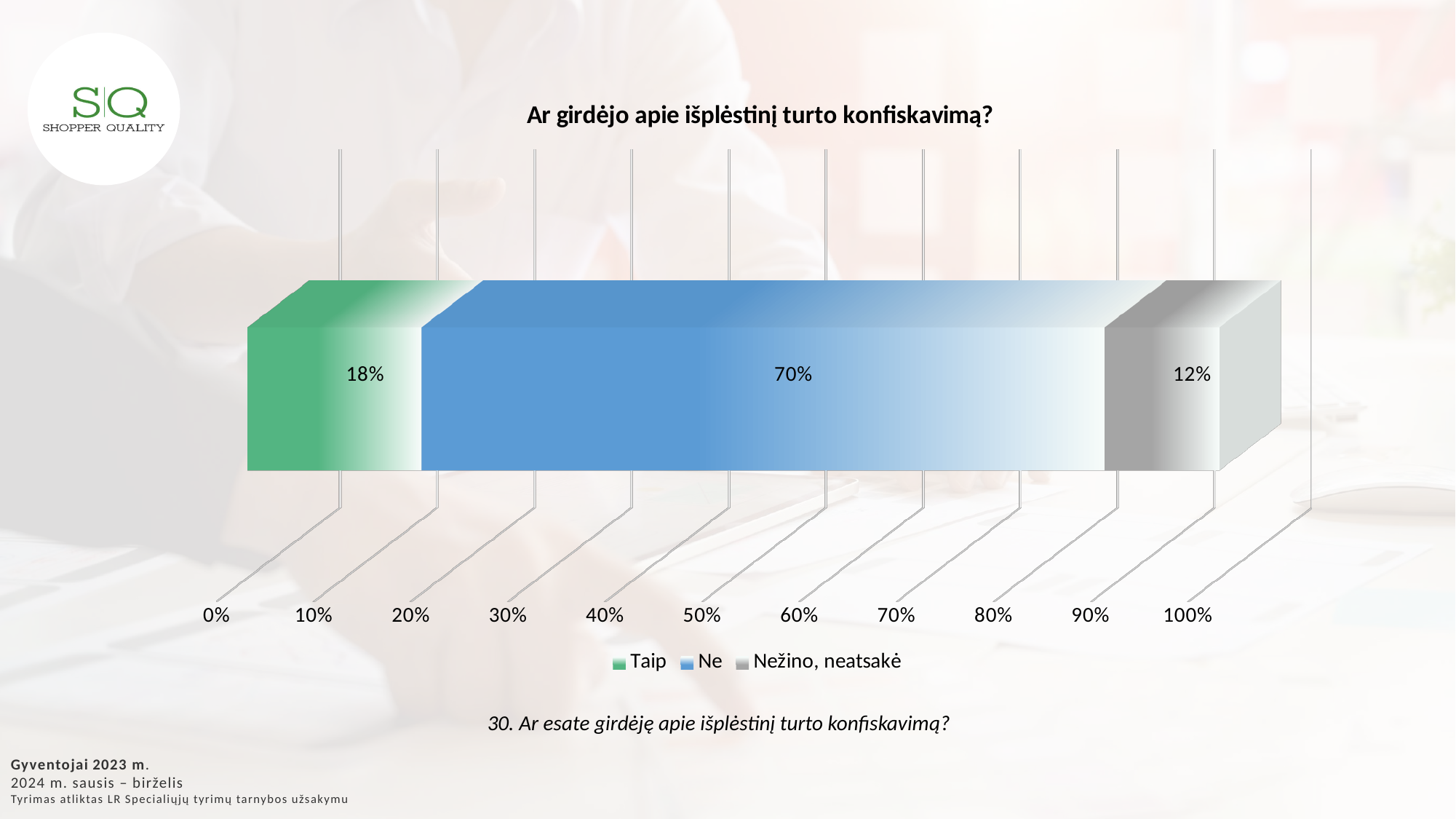
How many series does the legend list? 3 Which is larger, the share for "Taip" or the share for "Nežino, neatsakė"? Taip What is the difference in percentage points between "Taip" and "Nežino, neatsakė"? 6 Which response has the largest share in the chart? Ne What kind of chart is shown on the slide? Stacked bar chart What colour is the "Ne" segment in the chart? Blue Which response has the smallest share in the chart? Nežino, neatsakė What is the difference in percentage points between "Ne" and "Taip"? 52 What percentage of respondents answered "Nežino, neatsakė"? 12% What is the total of the three segments in the stacked bar? 100% What percentage of respondents answered "Taip" in the chart "Ar girdėjo apie išplėstinį turto konfiskavimą?"? 18% What percentage of respondents answered "Ne"? 70%